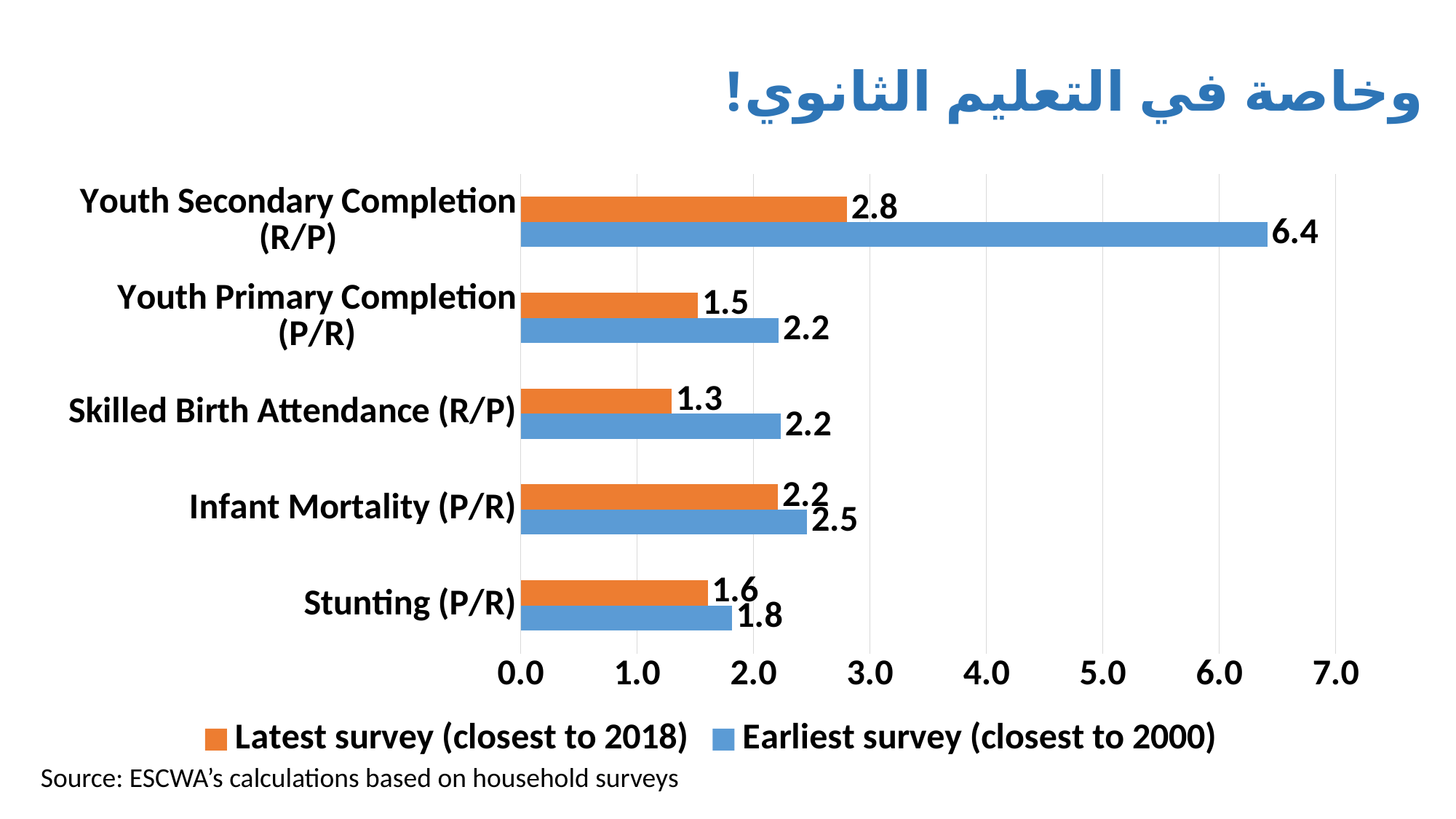
What is the difference between the Earliest survey and Latest survey values for Youth Secondary Completion (R/P)? 3.6 What is the Earliest survey (closest to 2000) value for Youth Secondary Completion (R/P)? 6.4 What is the Latest survey (closest to 2018) value for Infant Mortality (P/R)? 2.2 Is the Earliest survey (closest to 2000) value for Youth Secondary Completion (R/P) greater or less than 6.0? greater What is the Latest survey (closest to 2018) value for Skilled Birth Attendance (R/P)? 1.3 How many series does the legend list? 2 Which category has the highest Earliest survey (closest to 2000) value? Youth Secondary Completion (R/P) Which colour represents the Latest survey (closest to 2018) series? orange Which is larger for Stunting (P/R): the Latest survey value or the Earliest survey value? Earliest survey (closest to 2000) Which category has the lowest Latest survey (closest to 2018) value? Skilled Birth Attendance (R/P) What kind of chart is shown on the slide? bar chart How many categories are shown on the chart? 5